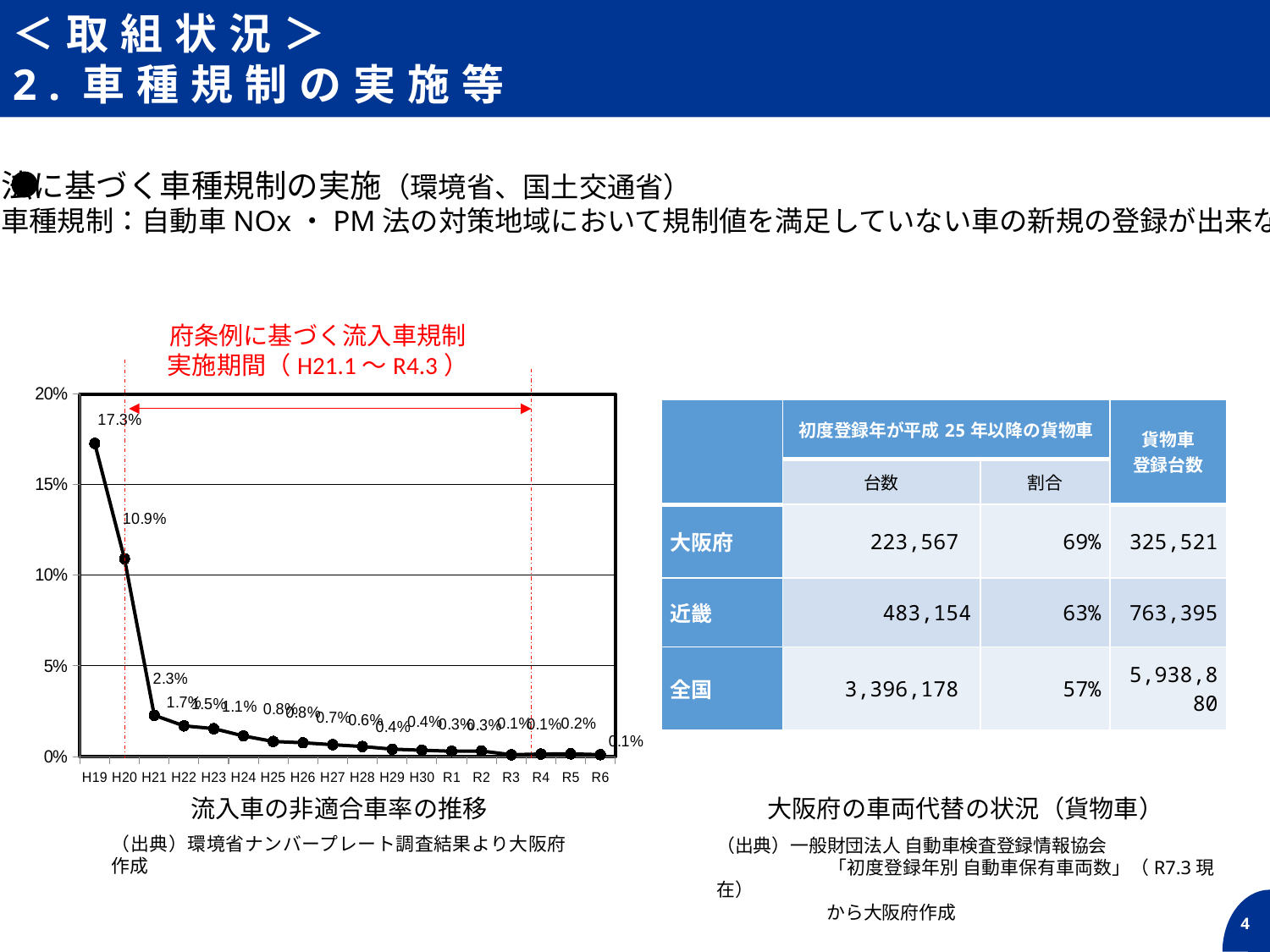
What kind of chart is the 流入車の非適合車率の推移 chart? line chart What is the value for H21 in the 流入車の非適合車率の推移 chart? 2.3% What is the value for H20 in the 流入車の非適合車率の推移 chart? 10.9% In the 流入車の非適合車率の推移 chart, is the value for H19 greater or less than 15%? greater What is the value for H19 in the 流入車の非適合車率の推移 chart? 17.3% In the 流入車の非適合車率の推移 chart, which is larger, the value for H20 or the value for H21? H20 Do the values in the 流入車の非適合車率の推移 chart generally rise or fall from H19 to R6? fall What is the difference between the values for H19 and H20 in the 流入車の非適合車率の推移 chart? 6.4% In the 流入車の非適合車率の推移 chart, is the value for H21 greater or less than 5%? less What is the value for R6 in the 流入車の非適合車率の推移 chart? 0.1% Which year has the highest value in the 流入車の非適合車率の推移 chart? H19 How many years are plotted on the x axis of the 流入車の非適合車率の推移 chart? 18